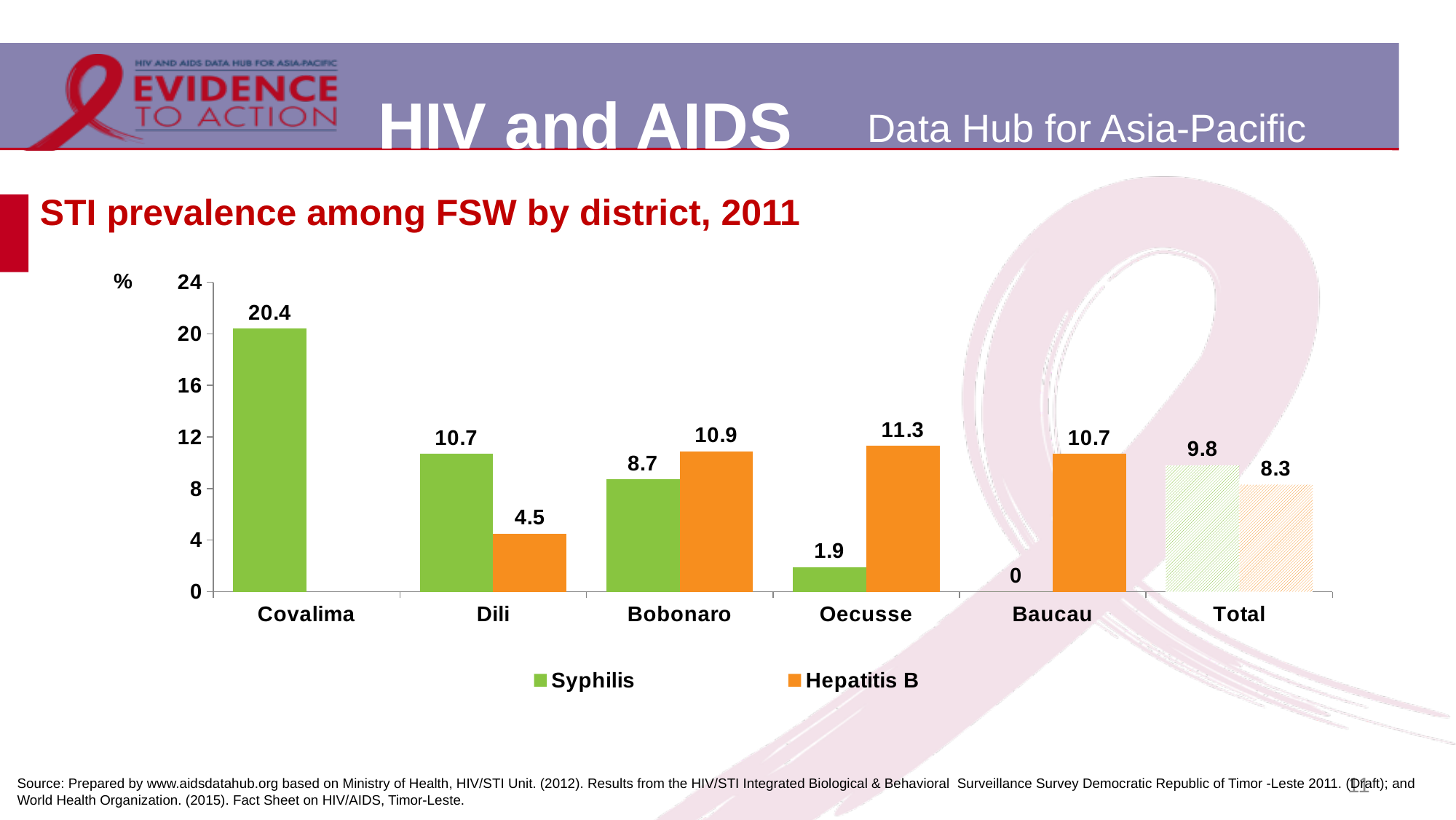
What type of chart is shown on the slide? Bar chart What is the difference between the Syphilis and Hepatitis B values in Dili? 6.2 What is the Hepatitis B prevalence among FSW in Oecusse? 11.3 What is the Syphilis prevalence among FSW in Covalima? 20.4 What is the Syphilis prevalence among FSW in Baucau? 0 Which district has the lowest Hepatitis B prevalence among those with a Hepatitis B bar? Dili Is the Syphilis value for Covalima greater or less than 16? greater What is the Hepatitis B value for the Total category? 8.3 Which district has the highest Syphilis prevalence? Covalima How many series does the legend list? 2 In Bobonaro, which is higher: Syphilis or Hepatitis B? Hepatitis B How many categories are shown on the x axis? 6